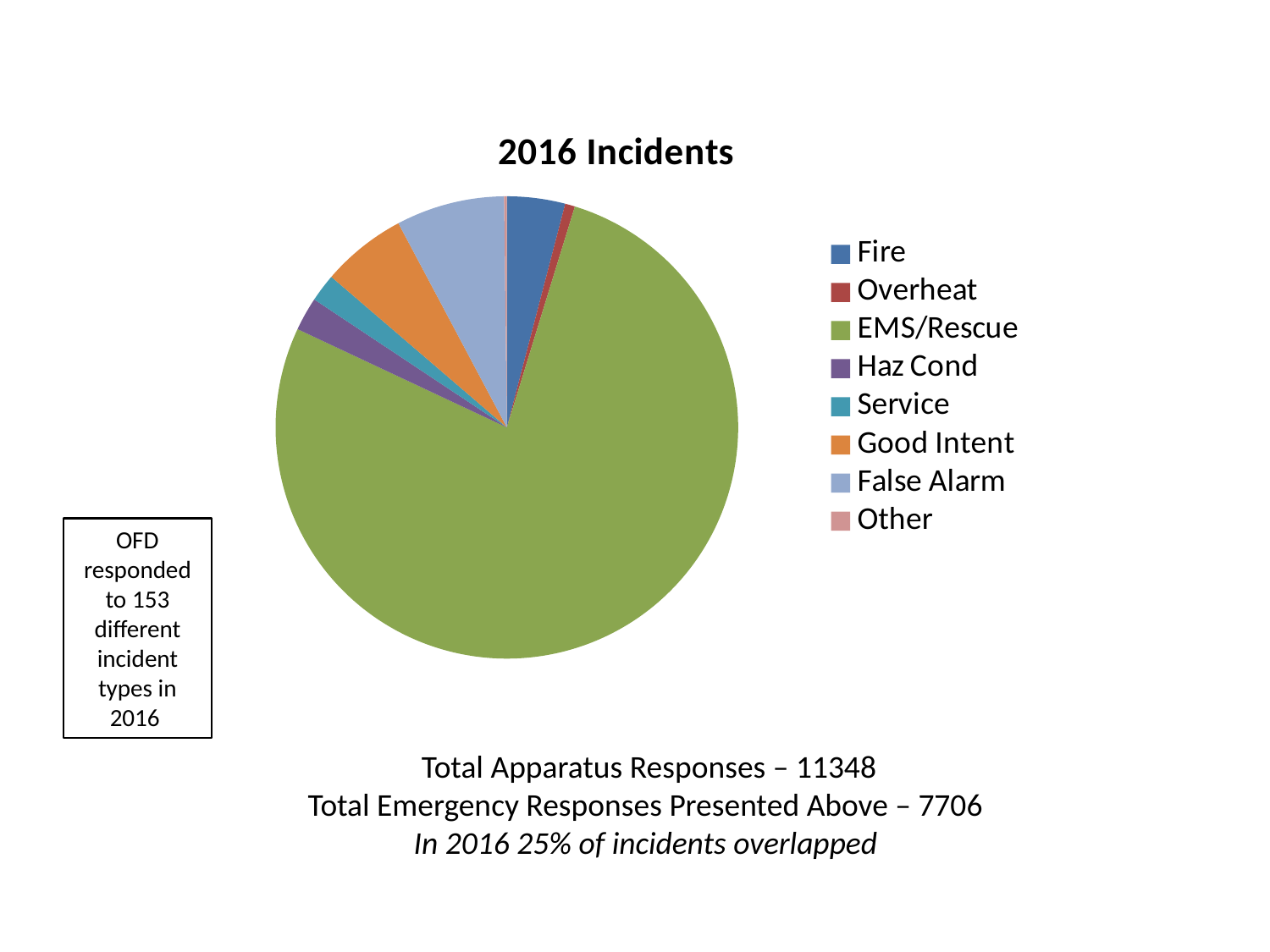
How many categories does the legend of the pie chart list? 8 Which is larger, the slice for Fire or the slice for Overheat? Fire Which is larger, the slice for EMS/Rescue or the slice for False Alarm? EMS/Rescue What kind of chart is shown on the slide? pie chart Which category is shown in green in the pie chart? EMS/Rescue Which is larger, the slice for False Alarm or the slice for Fire? False Alarm What is the title of the chart? 2016 Incidents Which category has the largest slice of the pie? EMS/Rescue